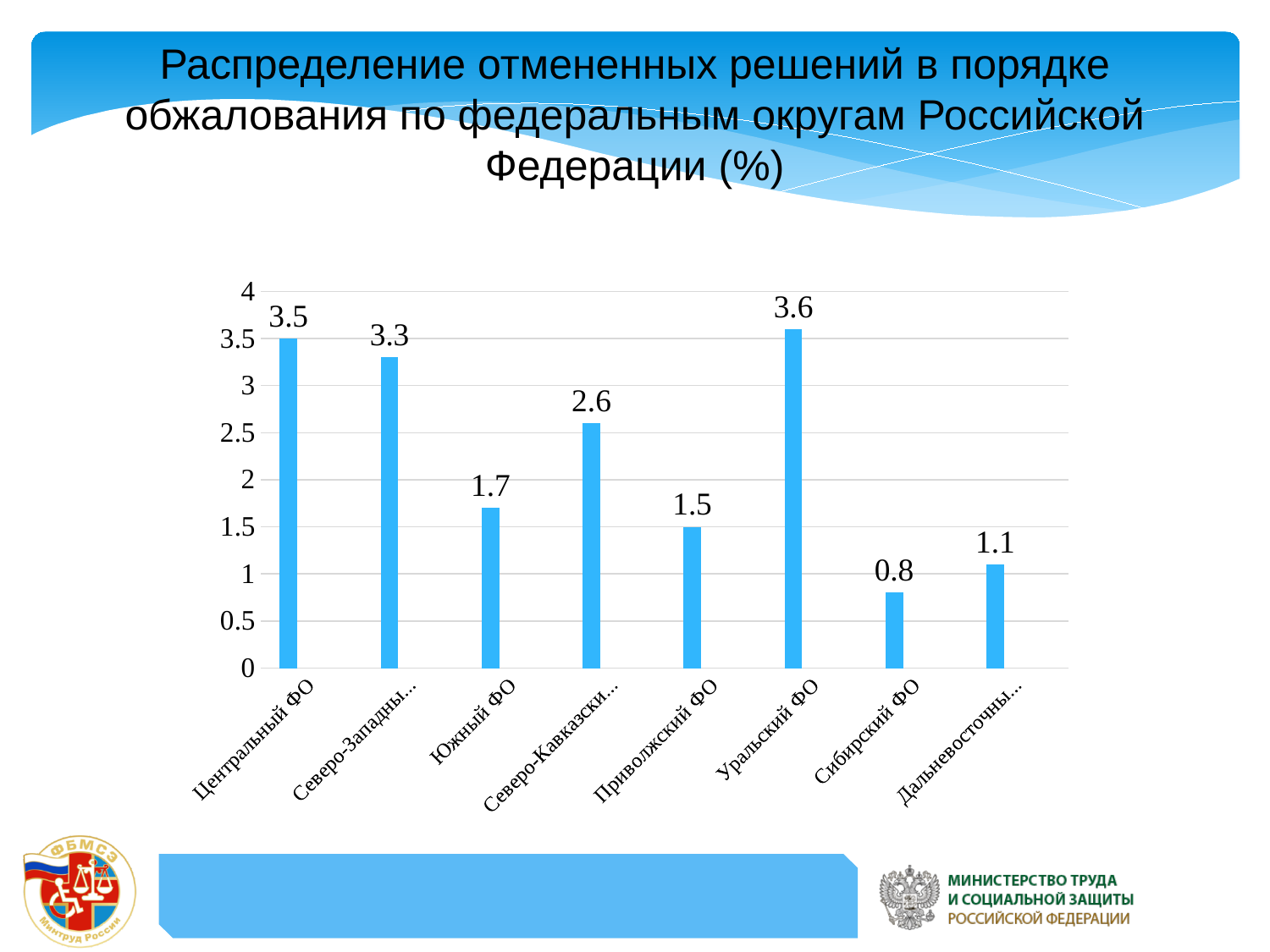
What is the difference between the values for Центральный ФО and Южный ФО? 1.8 What is the difference between the values for Уральский ФО and Сибирский ФО? 2.8 Which is larger, the value for Южный ФО or the value for Приволжский ФО? Южный ФО Which federal district has the highest value? Уральский ФО What is the value for Уральский ФО? 3.6 How many federal districts are shown on the chart? 8 What is the value for Центральный ФО? 3.5 What kind of chart is shown on the slide? bar chart Is the value for Северо-Кавказски... greater or less than 2? greater What is the value for Сибирский ФО? 0.8 What is the value for Приволжский ФО? 1.5 Which federal district has the lowest value? Сибирский ФО